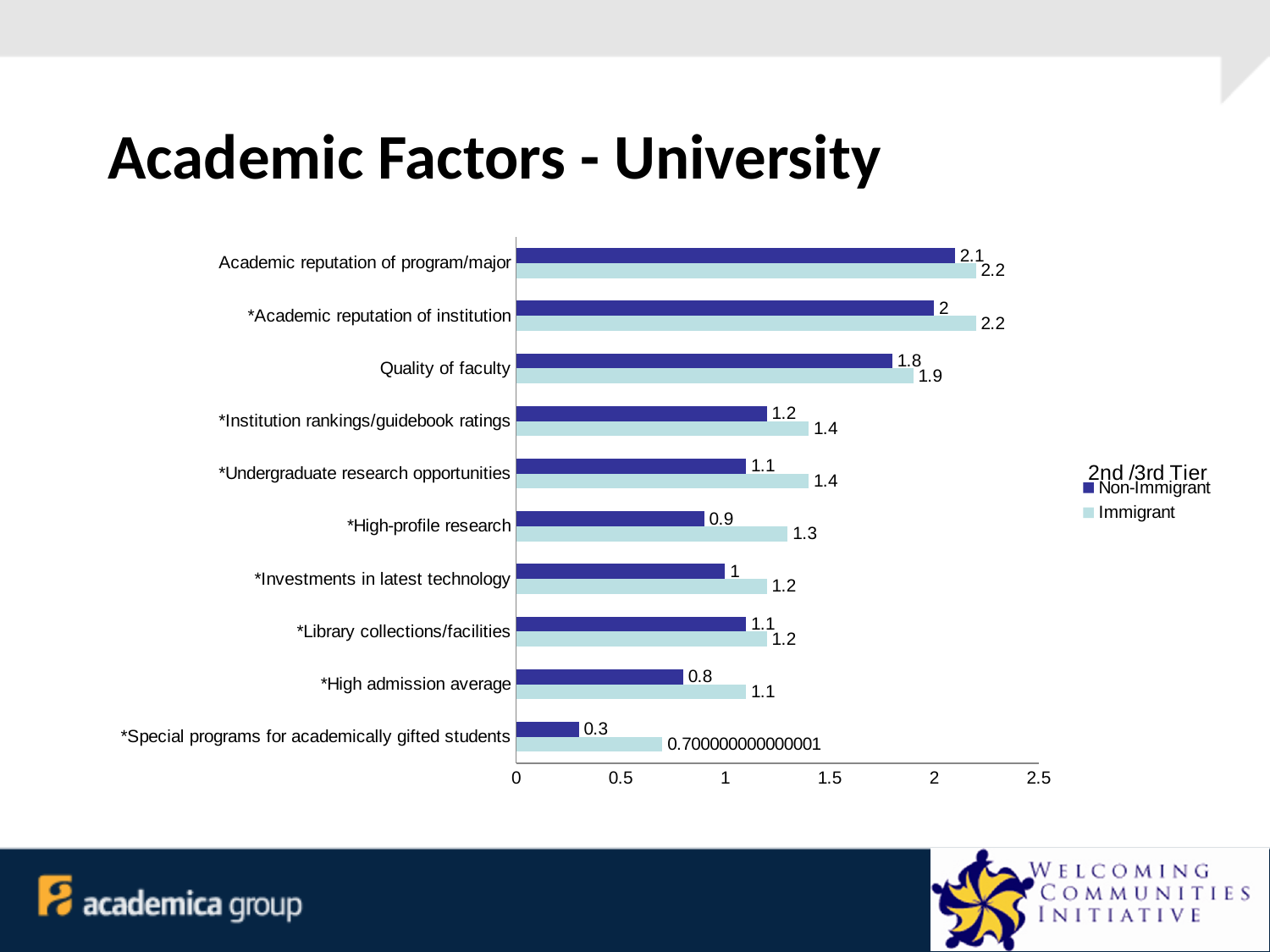
What is the difference between the Immigrant and Non-Immigrant values for *High-profile research? 0.4 What is the Non-Immigrant value for *High admission average? 0.8 What is the Immigrant value for *High-profile research? 1.3 What is the Non-Immigrant value for Quality of faculty? 1.8 What kind of chart is shown on the slide? Bar chart Which category has the highest Immigrant value among those with a single highest bar, Quality of faculty or Academic reputation of program/major? Academic reputation of program/major How many categories are shown on the chart? 10 Which category has the lowest Non-Immigrant value? *Special programs for academically gifted students How many series does the legend list? 2 Is the Non-Immigrant value for *Academic reputation of institution greater or less than 1.5? greater What is the difference between the Immigrant and Non-Immigrant values for *Undergraduate research opportunities? 0.3 For *Institution rankings/guidebook ratings, which is larger, the Non-Immigrant value or the Immigrant value? Immigrant